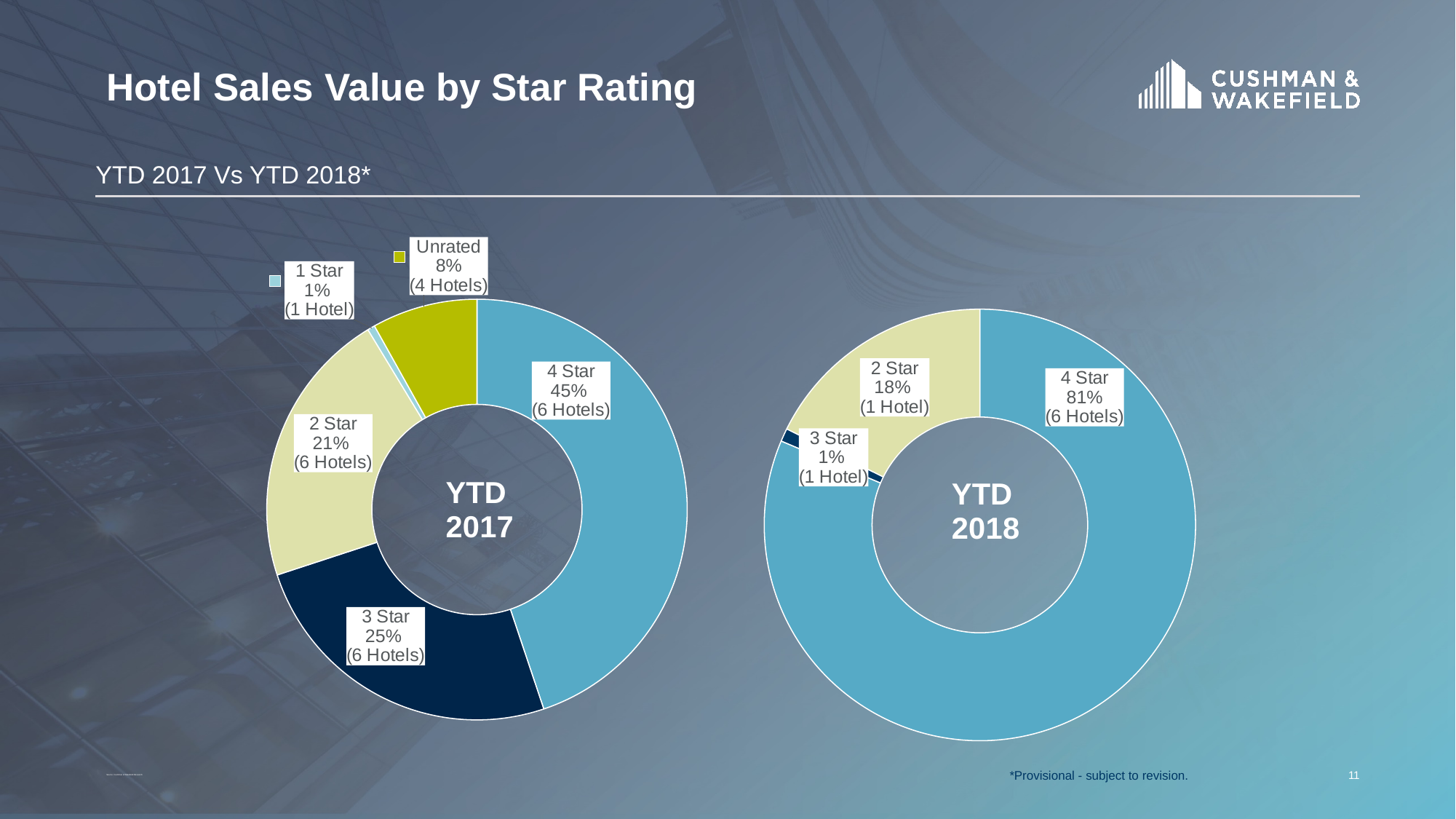
What is the difference in percentage points between the 4 Star share in YTD 2018 and the 4 Star share in YTD 2017? 36 percentage points In the YTD 2018 chart, what share of hotel sales value is 2 Star? 18% In the YTD 2017 chart, what share of hotel sales value is 4 Star? 45% In the YTD 2017 chart, which star rating category has the largest share? 4 Star In the YTD 2017 chart, which star rating category has the smallest share? 1 Star In the YTD 2018 chart, which category has the smallest share? 3 Star In the YTD 2017 chart, how many hotels are in the 3 Star category? 6 Hotels In the YTD 2018 chart, what share of hotel sales value is 4 Star? 81% In the YTD 2017 chart, which has a larger share, Unrated or 3 Star? 3 Star In the YTD 2017 chart, what is the difference in percentage points between the 3 Star and 2 Star shares? 4 percentage points What type of chart is used on this slide? Donut (pie) chart How many categories are shown in the YTD 2017 chart? 5